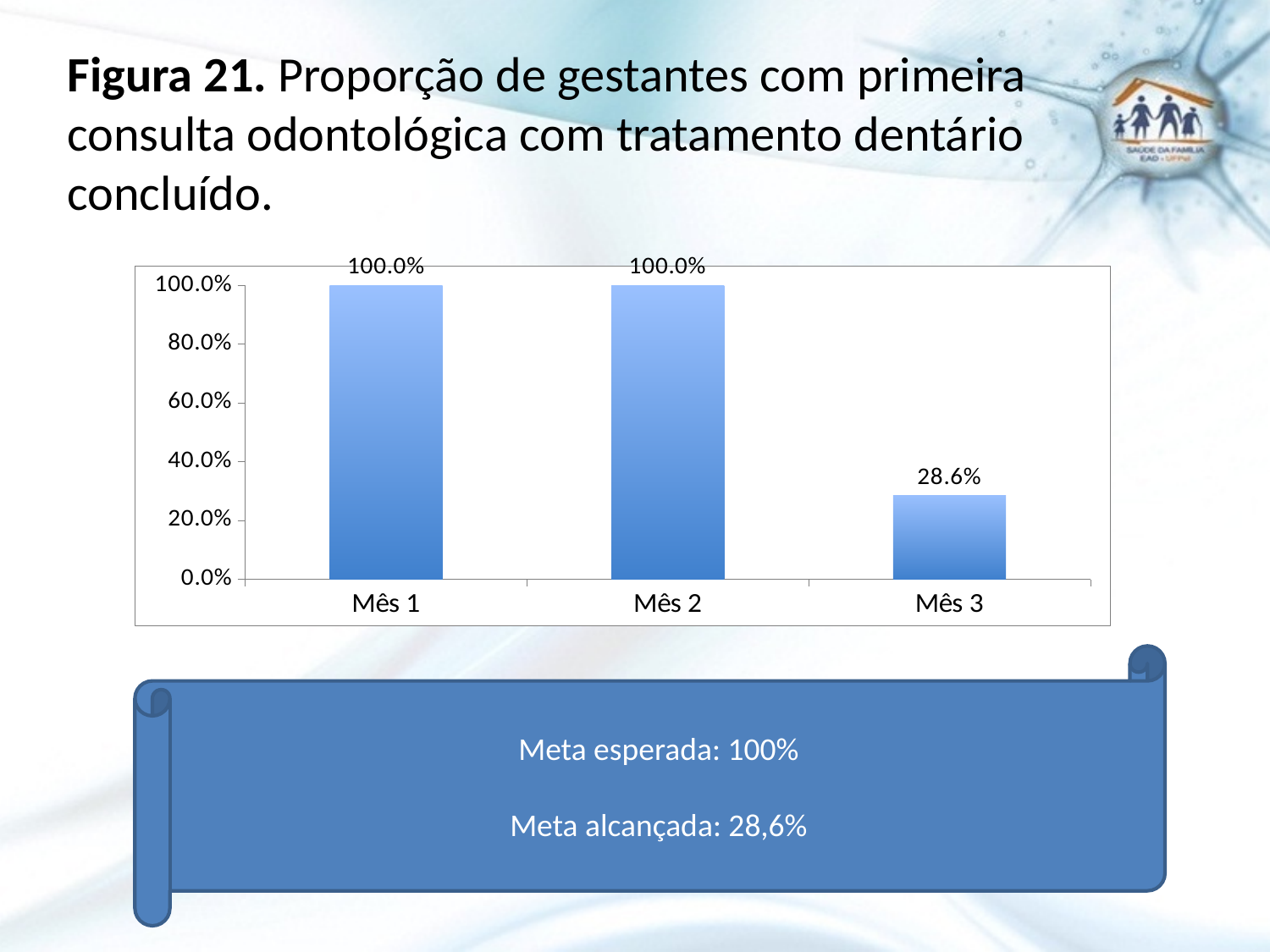
What is the value for Mês 3? 28.6% Do the values rise or fall from Mês 2 to Mês 3? fall What colour are the bars in the chart? blue What kind of chart is shown on the slide? bar chart Which is larger, the value for Mês 1 or the value for Mês 3? Mês 1 Which month has the lowest value? Mês 3 What is the highest value shown on the y axis? 100.0% Is the value for Mês 3 greater or less than 40.0%? less What is the difference between the values for Mês 2 and Mês 3? 71.4% How many categories are shown on the x axis? 3 What is the value for Mês 2? 100.0% What is the value for Mês 1? 100.0%